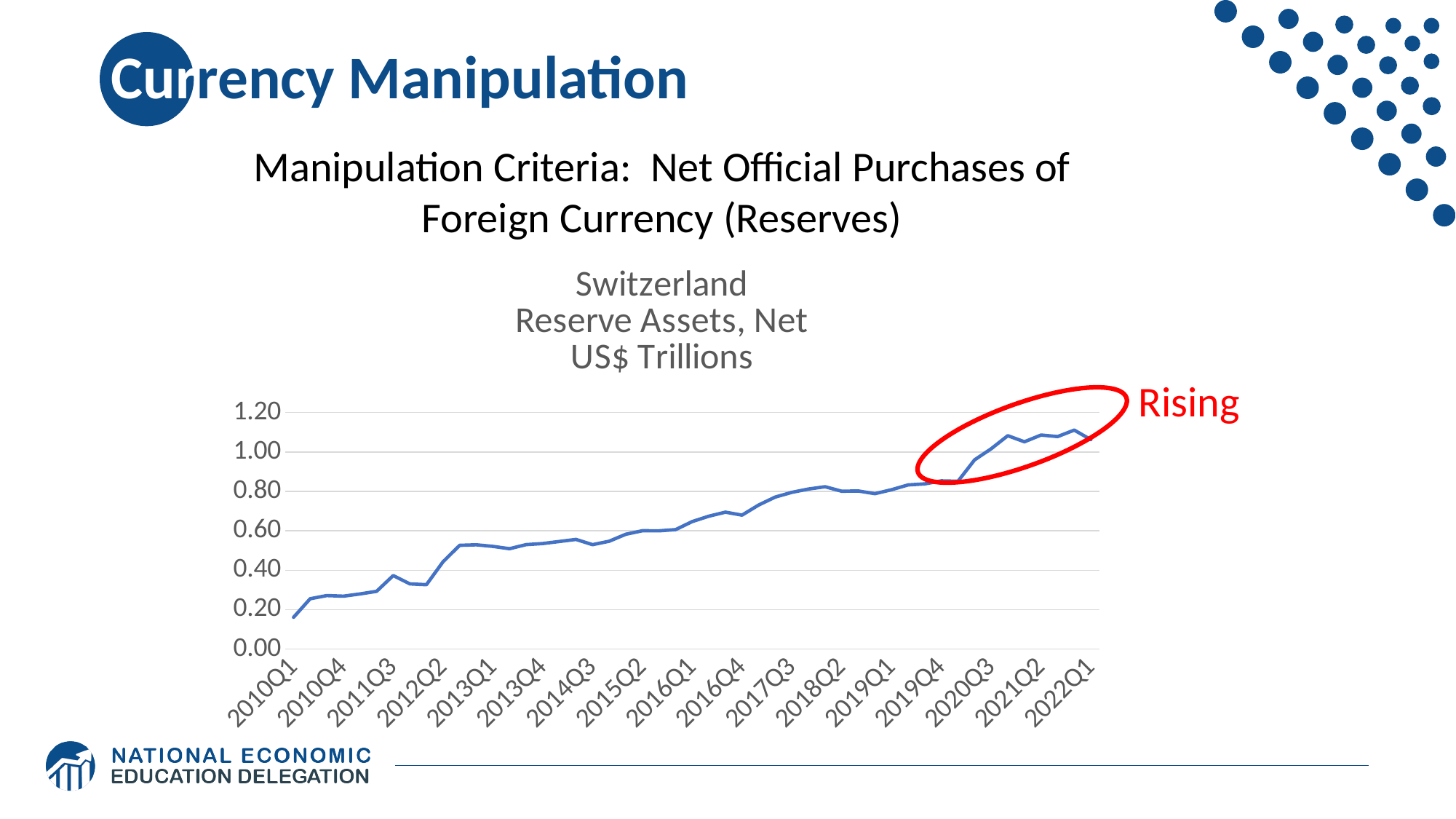
Which quarter has the lowest value on the chart? 2010Q1 Is the value for 2010Q1 greater or less than 0.20? less Is the value for 2013Q1 greater or less than 0.60? less Do the values generally rise or fall from 2010Q1 to 2022Q1? rise What kind of chart is shown on the slide? line chart What is the title of the chart? Switzerland Reserve Assets, Net US$ Trillions Is the value for 2014Q3 greater or less than 0.60? less Which is larger, the value for 2016Q4 or the value for 2012Q2? 2016Q4 What word is written in red next to the circled part of the line? Rising